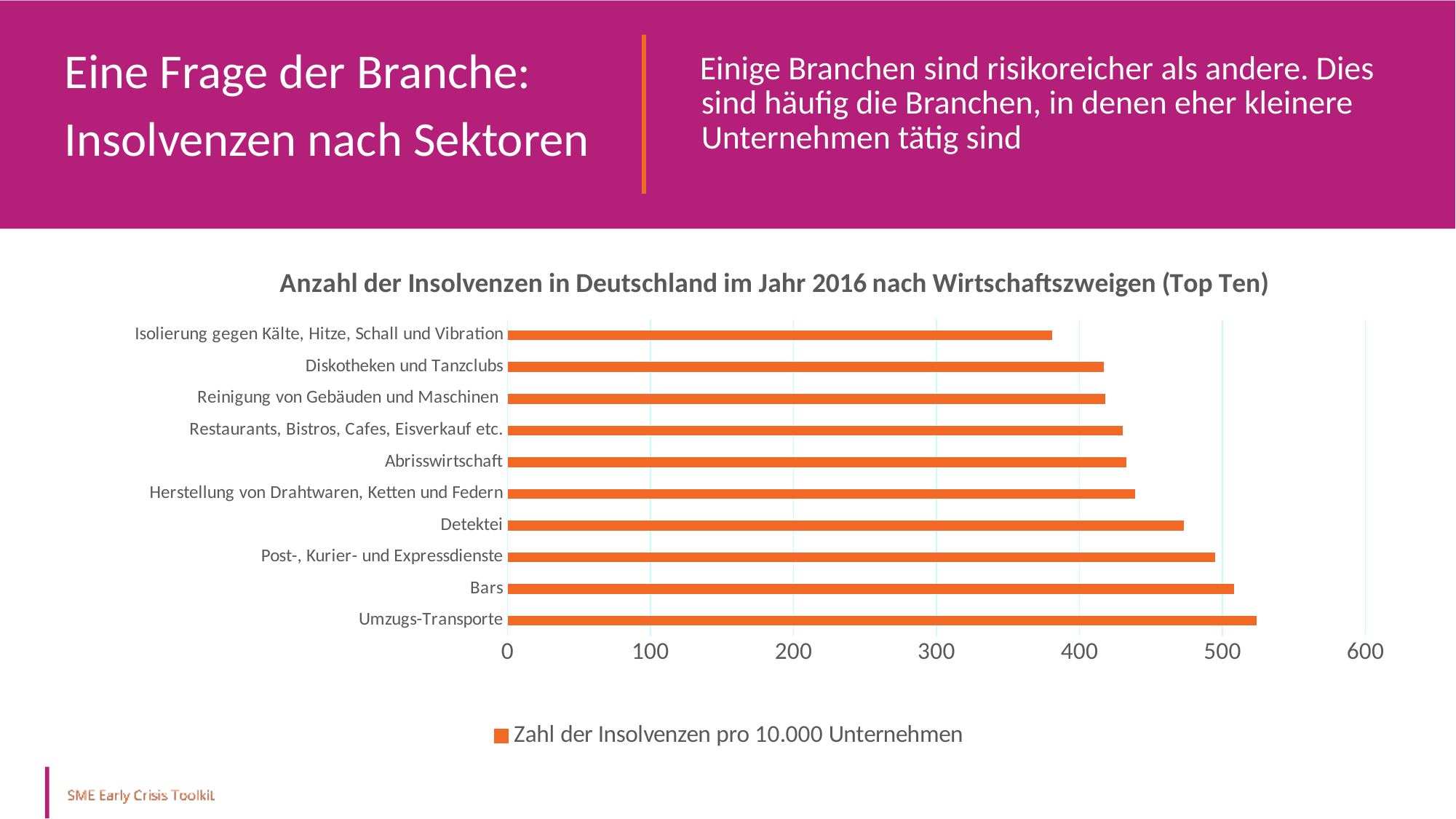
Which sector has the highest number of insolvencies in the chart? Umzugs-Transporte What kind of chart is shown on the slide? bar chart Which has a higher value, Bars or Isolierung gegen Kälte, Hitze, Schall und Vibration? Bars Is the value for Isolierung gegen Kälte, Hitze, Schall und Vibration greater or less than 400? less Is the value for Abrisswirtschaft greater or less than 400? greater Which sector has the lowest number of insolvencies in the chart? Isolierung gegen Kälte, Hitze, Schall und Vibration Is the value for Umzugs-Transporte greater or less than 500? greater Which has a higher value, Detektei or Abrisswirtschaft? Detektei How many sectors (categories) are shown in the chart? 10 What is the legend entry for the series shown in the chart? Zahl der Insolvenzen pro 10.000 Unternehmen How many series does the legend list? 1